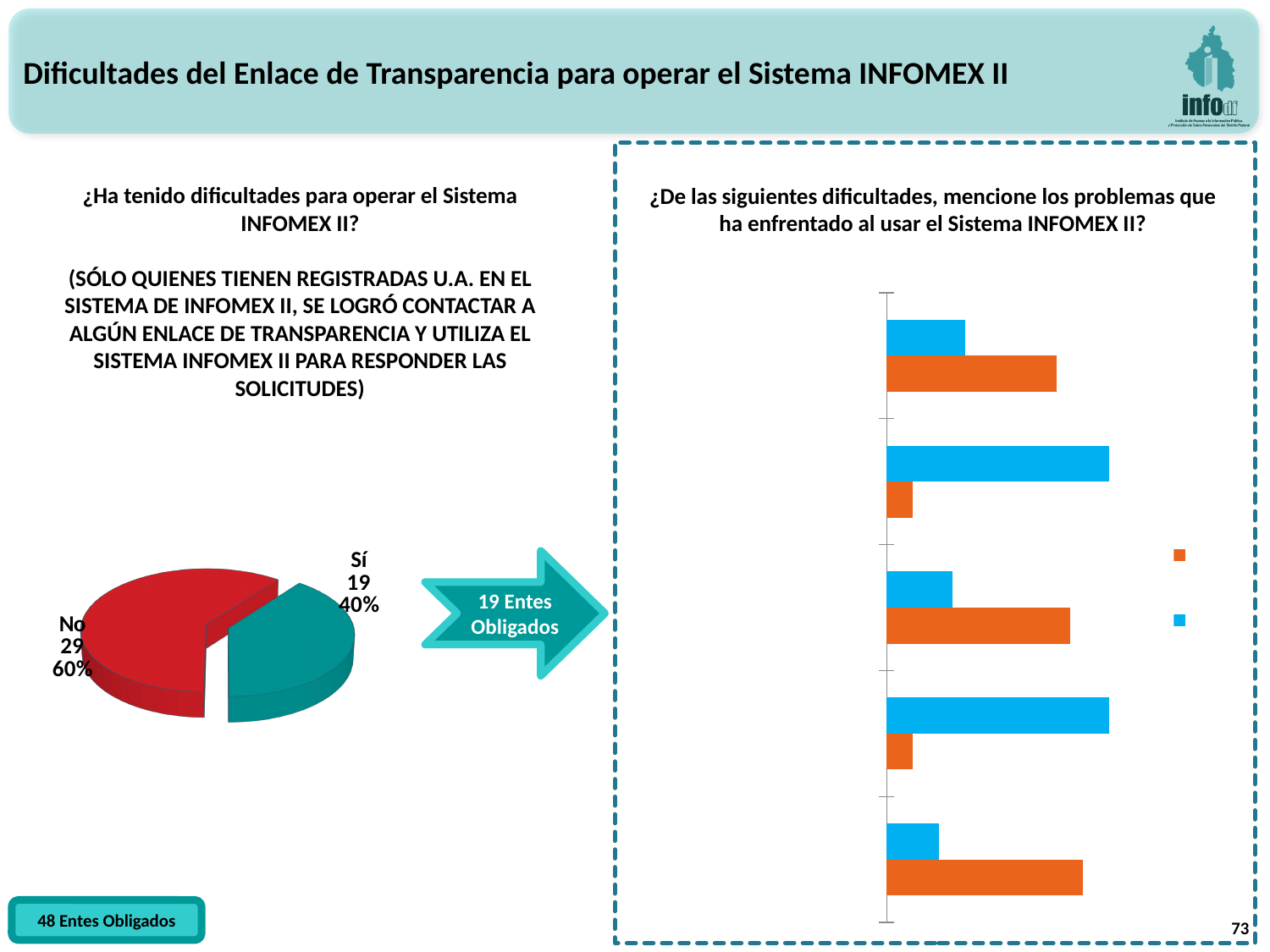
In the pie chart on the left, which answer has the smaller slice? Sí In the pie chart on the left, how many respondents answered "No"? 29 What type of chart is shown inside the dashed box on the right side of the slide? Bar chart In the pie chart on the left, what percentage of respondents answered "Sí"? 40% What type of chart is shown on the left side of the slide? Pie chart In the pie chart on the left, what percentage of respondents answered "No"? 60% In the pie chart on the left, how many slices are there? 2 In the bar chart on the right, how many series does the legend show? 2 In the pie chart on the left, which answer has the larger slice? No In the bar chart on the right, how many category groups of bars are plotted? 5 In the pie chart on the left, how many respondents answered "Sí"? 19 In the pie chart on the left, what is the difference between the number of "No" and "Sí" responses? 10